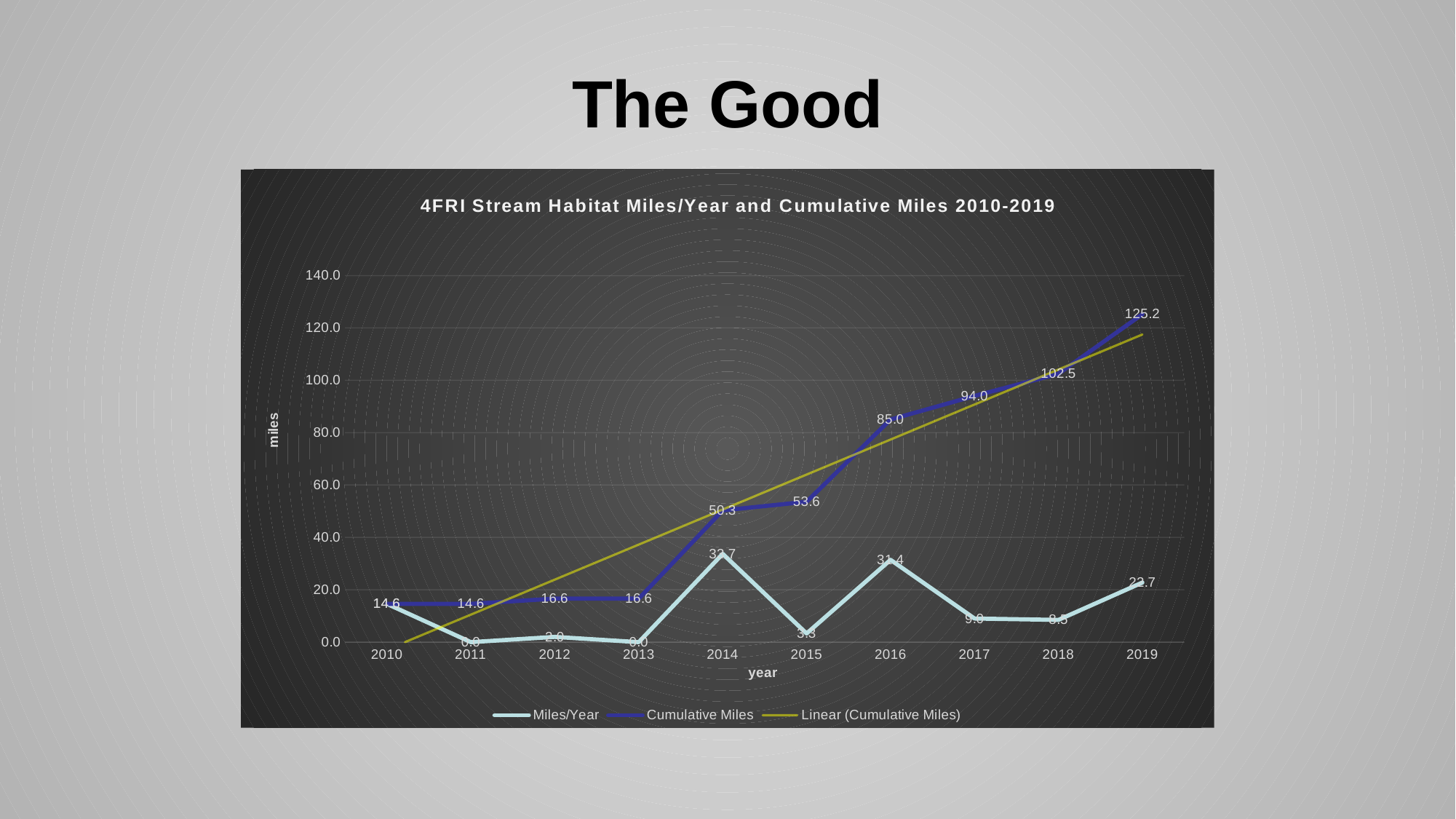
Which year has the larger Cumulative Miles value, 2017 or 2018? 2018 What is the difference between the Cumulative Miles values for 2014 and 2013? 33.7 Is the value of the Linear (Cumulative Miles) trend line at 2019 greater or less than 100? greater What is the Miles/Year value for 2010? 14.6 What is the Cumulative Miles value for 2016? 85.0 What is the difference between the Cumulative Miles values for 2019 and 2018? 22.7 What is the Cumulative Miles value for 2019? 125.2 Does the Cumulative Miles series rise or fall from 2010 to 2019? rise What kind of chart is shown on the slide? line chart How many years are shown on the x axis? 10 In which year is the Cumulative Miles value highest? 2019 How many series does the legend list? 3